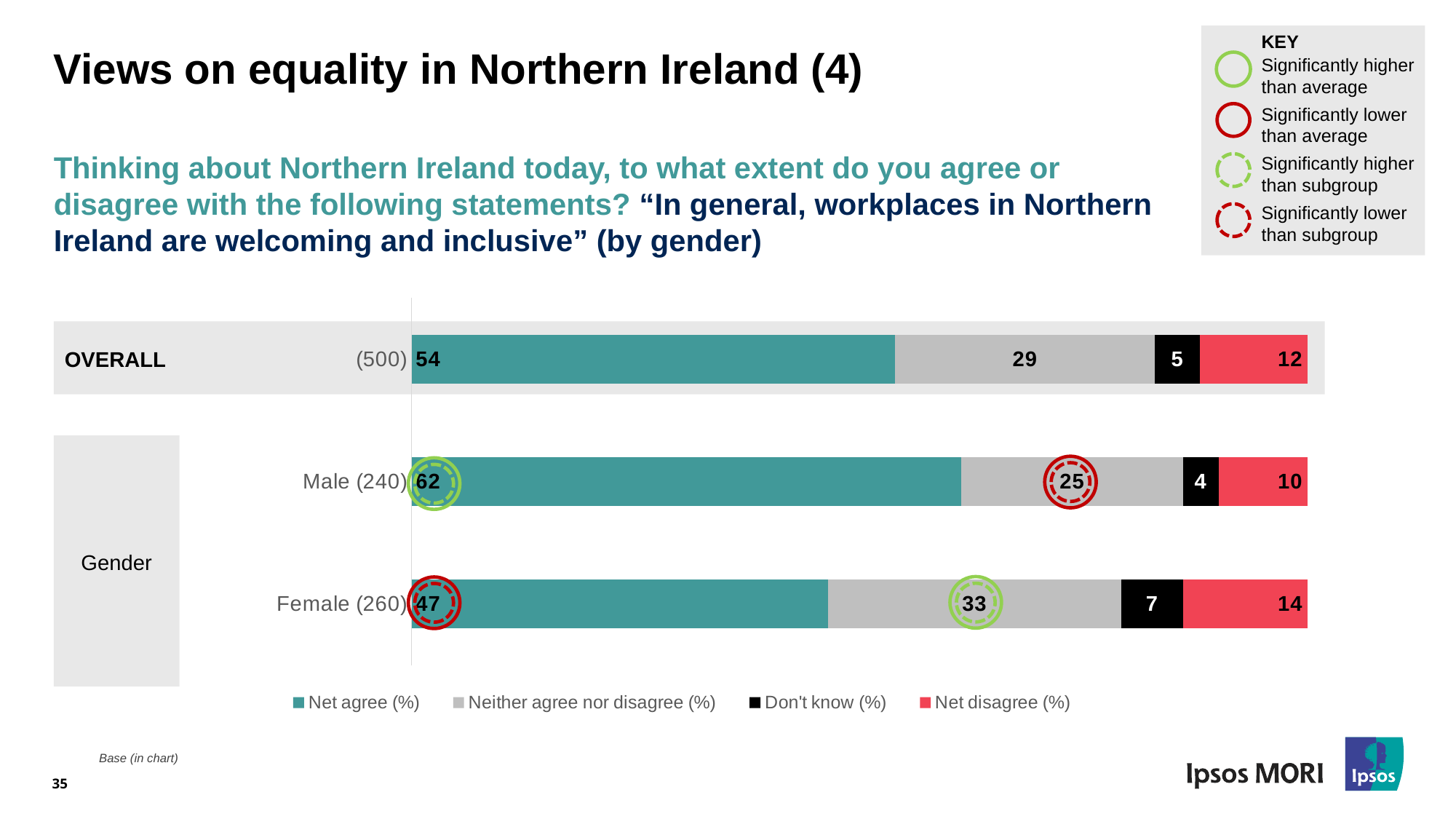
How many series does the legend list? 4 How many categories (bars) are shown in the chart? 3 What is the Net agree (%) value for Male? 62 What is the Neither agree nor disagree (%) value for OVERALL? 29 What is the difference between the Net agree (%) values for Male and Female? 15 What kind of chart is shown on the slide? Stacked bar chart What is the Don't know (%) value for Female? 7 What is the base (number of respondents) shown for Female? 260 Which category has the highest Net agree (%) value? Male Which is larger, the Neither agree nor disagree (%) value for Female or for Male? Female What is the Net disagree (%) value for Female? 14 Which category has the lowest Net disagree (%) value? Male